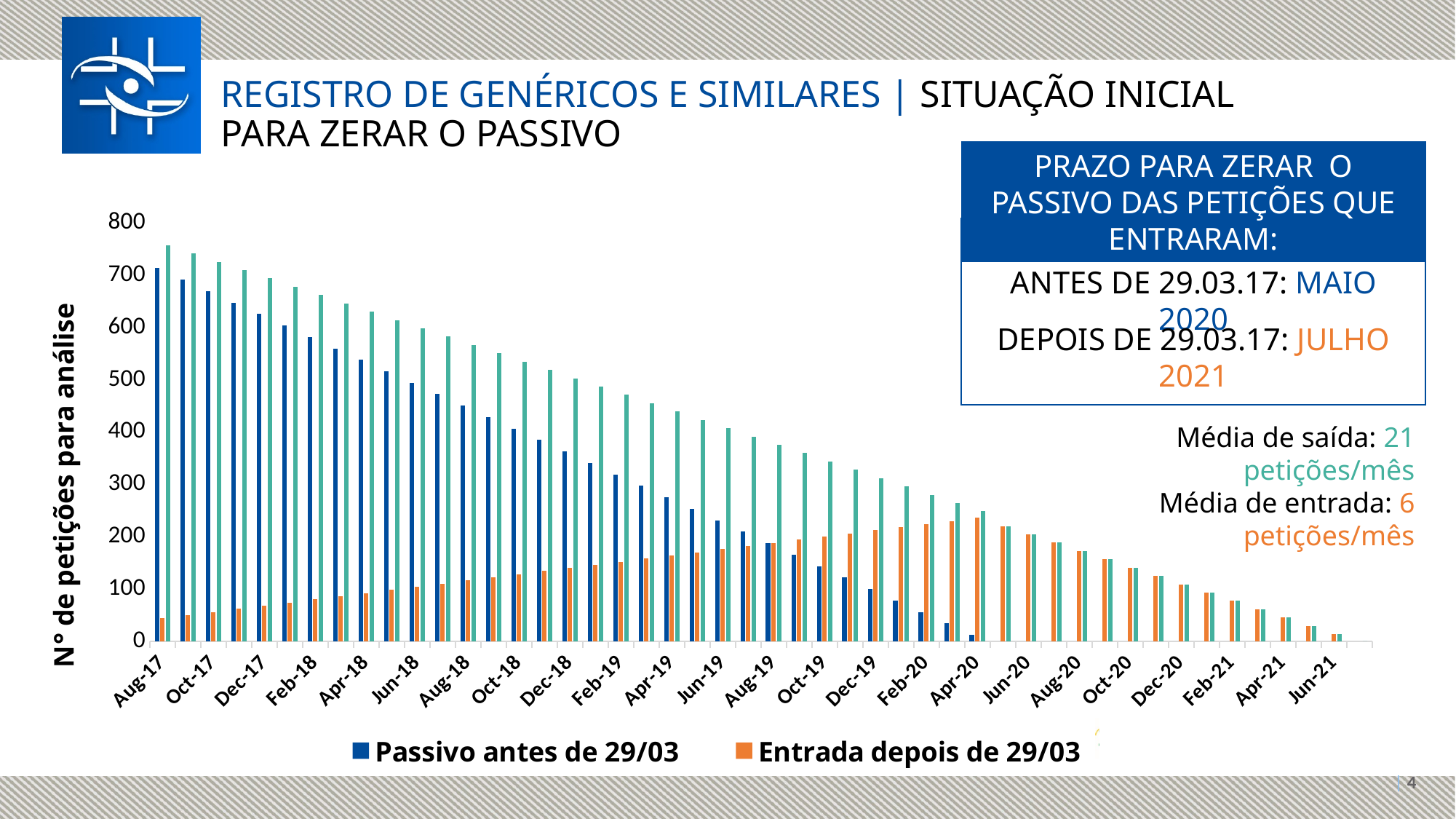
What is the title of the vertical axis of the chart? Nº de petições para análise How many series does the chart legend list? 2 Is the value of 'Entrada depois de 29/03' for Aug-17 greater or less than 100? less Is the value of 'Passivo antes de 29/03' for Aug-17 greater or less than 600? greater Is the value of 'Entrada depois de 29/03' for Apr-20 greater or less than 200? greater What kind of chart is shown on the slide? bar chart In which month is the 'Passivo antes de 29/03' series at its highest? Aug-17 For Apr-20, which is larger: 'Passivo antes de 29/03' or 'Entrada depois de 29/03'? Entrada depois de 29/03 Which colour represents the series 'Passivo antes de 29/03' in the chart? blue Does the 'Passivo antes de 29/03' series rise or fall from Aug-17 onwards along the x axis? fall For Aug-17, which is larger: 'Passivo antes de 29/03' or 'Entrada depois de 29/03'? Passivo antes de 29/03